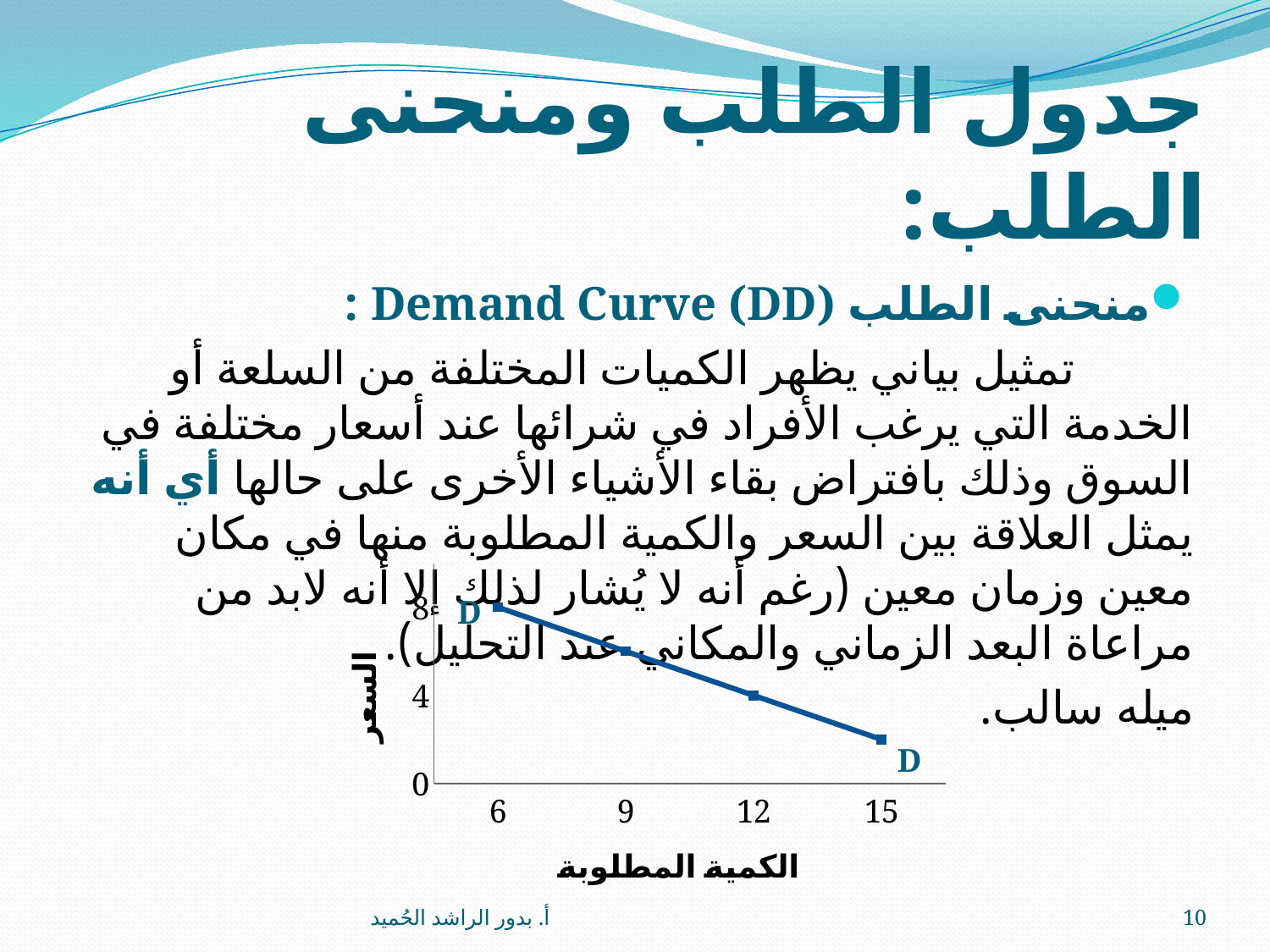
At which quantity demanded is the price lowest? 15 At which quantity demanded is the price highest? 6 What is the title of the x axis of the chart? الكمية المطلوبة Does the price rise or fall as the quantity demanded increases along the x axis? fall What is the price (السعر) when the quantity demanded is 12? 4 How many data points are plotted on the demand curve? 4 What is the price (السعر) when the quantity demanded is 6? 8 Which has the higher price: a quantity demanded of 6 or of 15? 6 What is the difference in price between a quantity demanded of 6 and a quantity demanded of 12? 4 What kind of chart is shown on the slide? line chart Is the price at a quantity demanded of 15 greater or less than 4? less Is the price at a quantity demanded of 9 greater or less than 4? greater